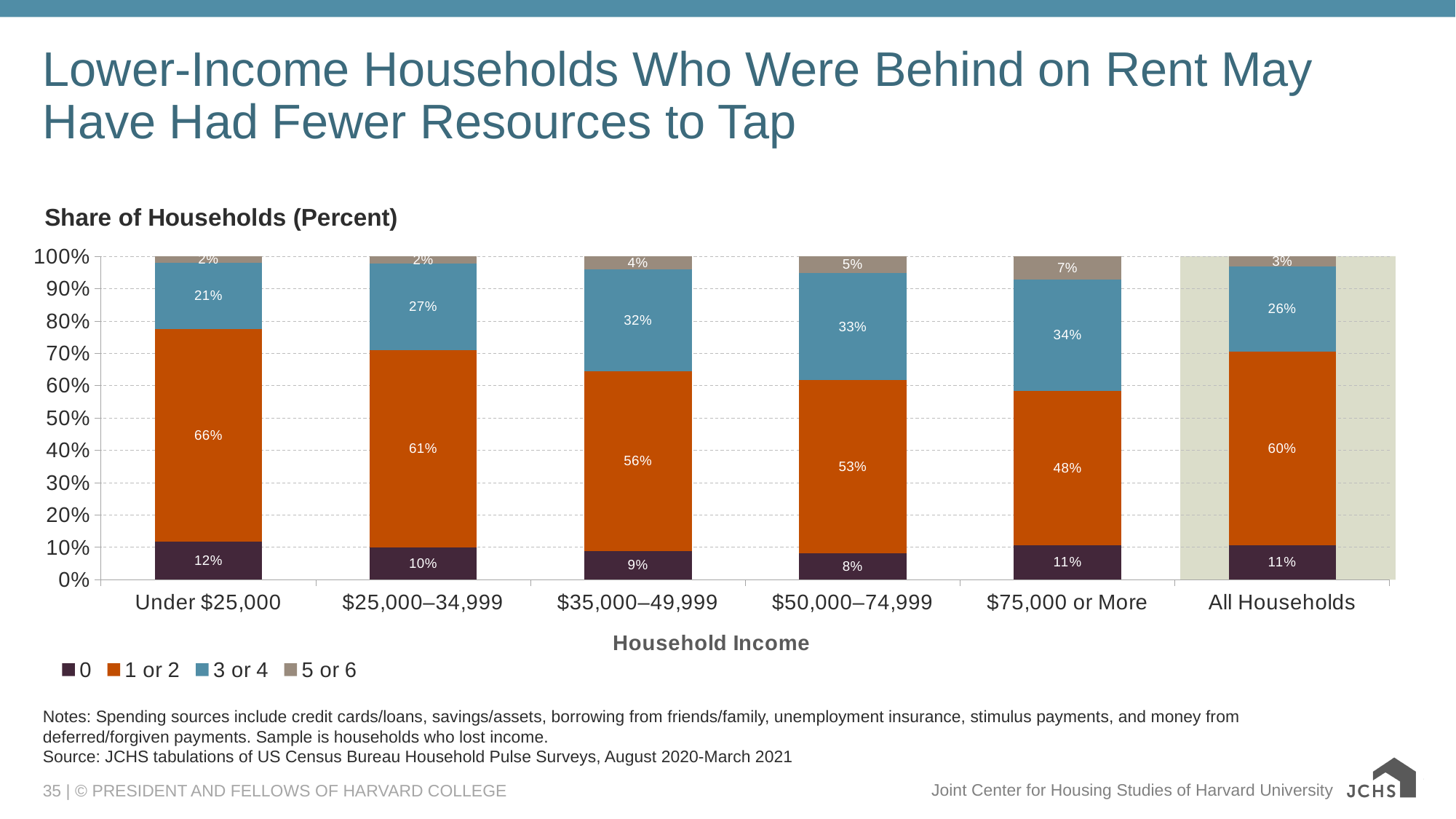
What share of households with income of $75,000 or more used 5 or 6 spending sources? 7% Which is larger: the share using 3 or 4 sources in the $35,000–49,999 group or in the $25,000–34,999 group? $35,000–49,999 What is the label of the x axis? Household Income What share of All Households used 3 or 4 spending sources? 26% Moving from Under $25,000 to $75,000 or More, does the share of households using 5 or 6 spending sources rise or fall? Rise How many series does the legend list? 4 How many household income categories are shown on the x axis? 6 What share of households with income under $25,000 used 1 or 2 spending sources? 66% What is the difference between the share of households using 1 or 2 sources in the Under $25,000 group and the $75,000 or More group? 18 percentage points Which household income category has the highest share using 1 or 2 spending sources? Under $25,000 What kind of chart is shown on the slide? Stacked bar chart Which household income category has the lowest share using 0 spending sources? $50,000–74,999